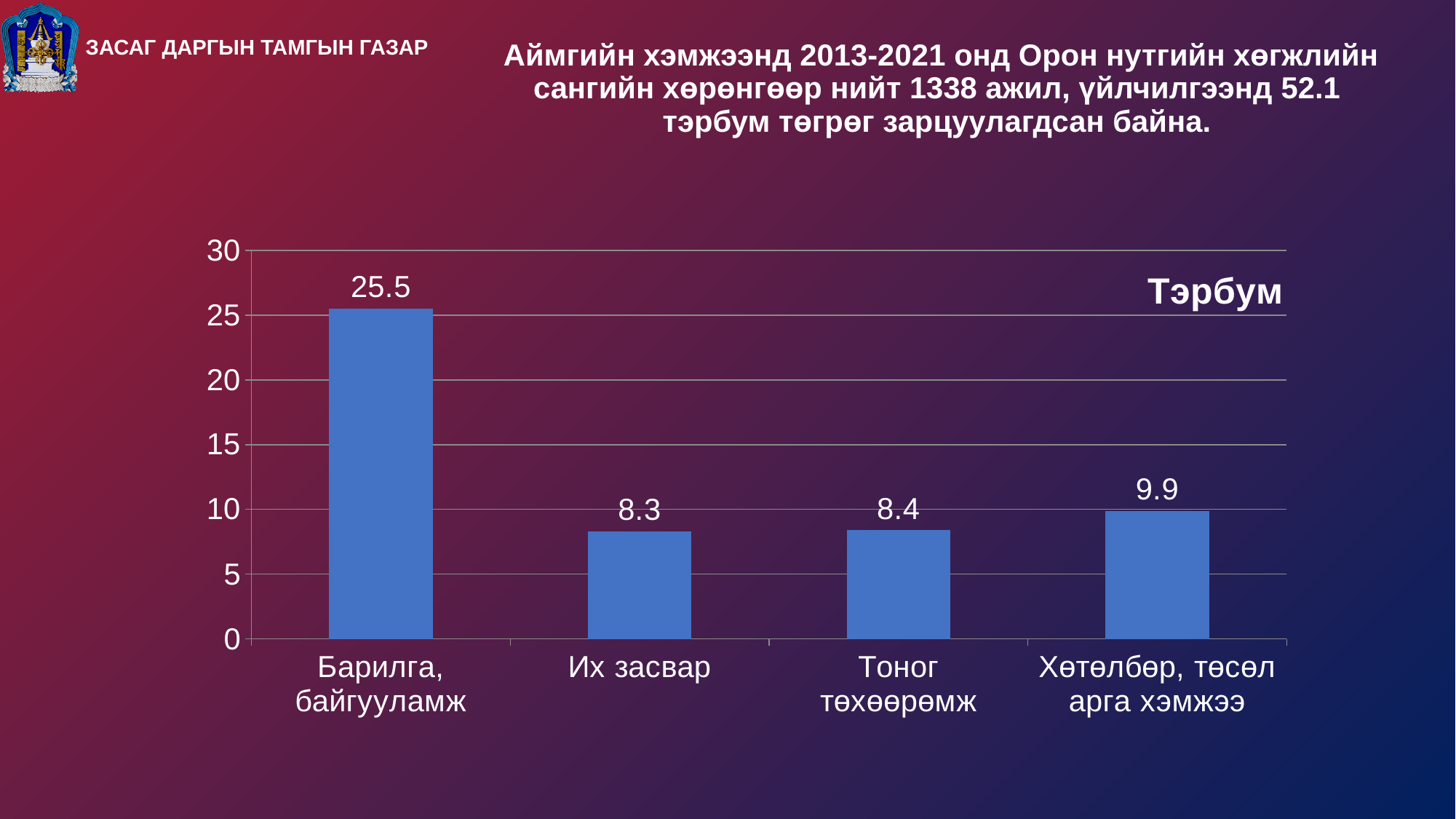
Which category has the highest value? Барилга, байгууламж Is the value for Барилга, байгууламж greater or less than 20? greater What is the value for Барилга, байгууламж? 25.5 What is the difference between the values for Хөтөлбөр, төсөл арга хэмжээ and Их засвар? 1.6 How many categories are shown on the chart? 4 What is the difference between the values for Барилга, байгууламж and Хөтөлбөр, төсөл арга хэмжээ? 15.6 What kind of chart is shown on the slide? bar chart What is the value for Тоног төхөөрөмж? 8.4 Is the value for Их засвар greater or less than 10? less Which is larger, the value for Хөтөлбөр, төсөл арга хэмжээ or the value for Тоног төхөөрөмж? Хөтөлбөр, төсөл арга хэмжээ What is the value for Хөтөлбөр, төсөл арга хэмжээ? 9.9 What is the value for Их засвар? 8.3